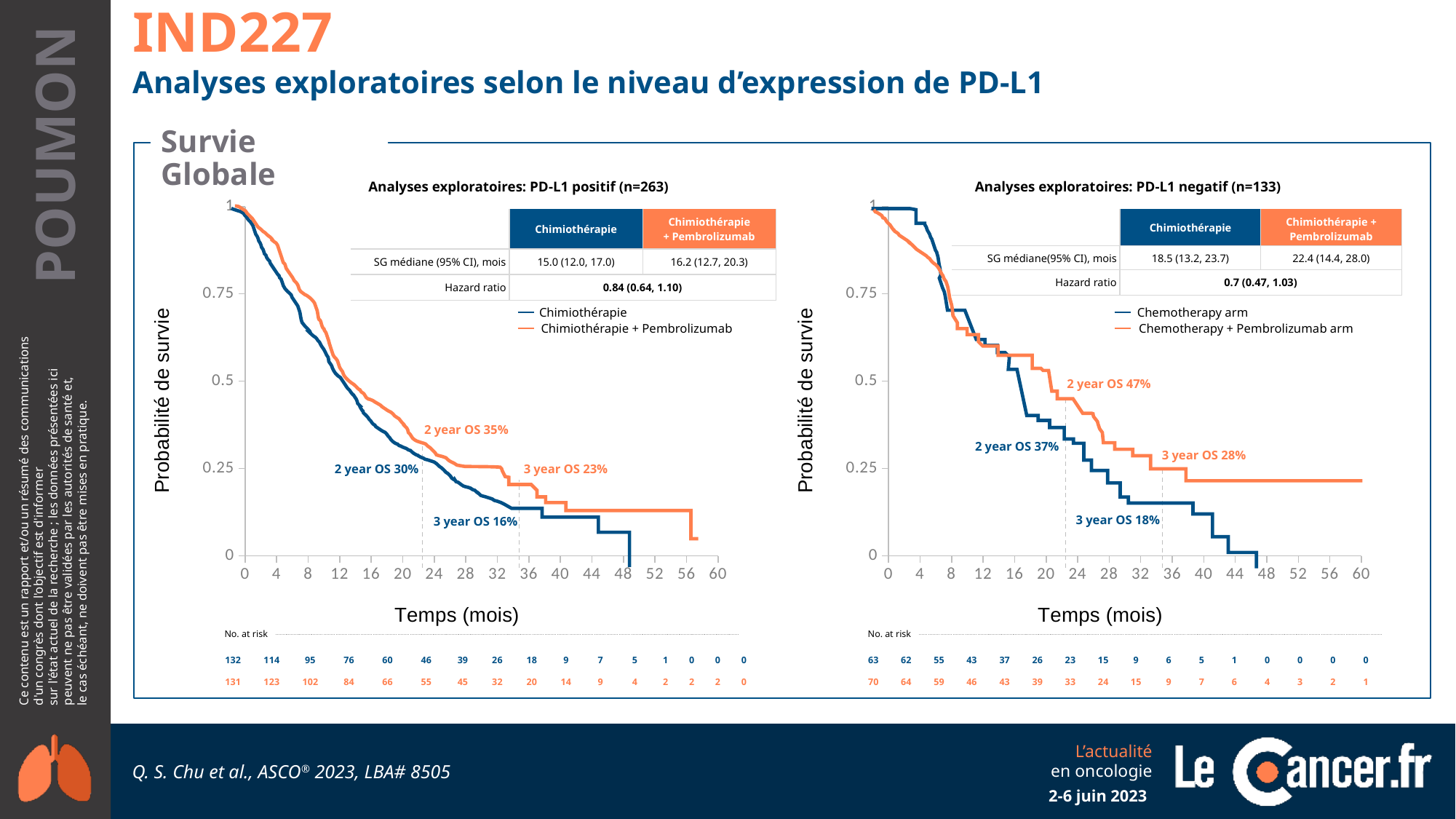
In the PD-L1 negatif chart, what is the median OS (SG médiane) for the Chimiothérapie + Pembrolizumab arm? 22.4 (14.4, 28.0) How many series does the legend of the PD-L1 positif chart list? 2 In the PD-L1 positif chart, do the survival probability curves rise or fall as time increases? Fall In the PD-L1 positif chart, what is the hazard ratio shown in the table? 0.84 (0.64, 1.10) What kind of chart is the PD-L1 negatif chart? Line chart (Kaplan-Meier survival curve) In the PD-L1 positif chart, what is the difference in 2 year OS between the Chimiothérapie + Pembrolizumab arm and the Chimiothérapie arm? 5% In the PD-L1 negatif chart, which arm has the higher 2 year OS? Chemotherapy + Pembrolizumab arm In the PD-L1 negatif chart, what is the difference in 3 year OS between the Chemotherapy + Pembrolizumab arm and the Chemotherapy arm? 10% In the PD-L1 positif chart, what is the 3 year OS for the Chimiothérapie arm? 16% In the PD-L1 positif chart, what is the 2 year OS for the Chimiothérapie + Pembrolizumab arm? 35% In the PD-L1 negatif chart, what is the 2 year OS for the Chemotherapy + Pembrolizumab arm? 47% In the PD-L1 negatif chart, what is the 3 year OS for the Chemotherapy arm? 18%